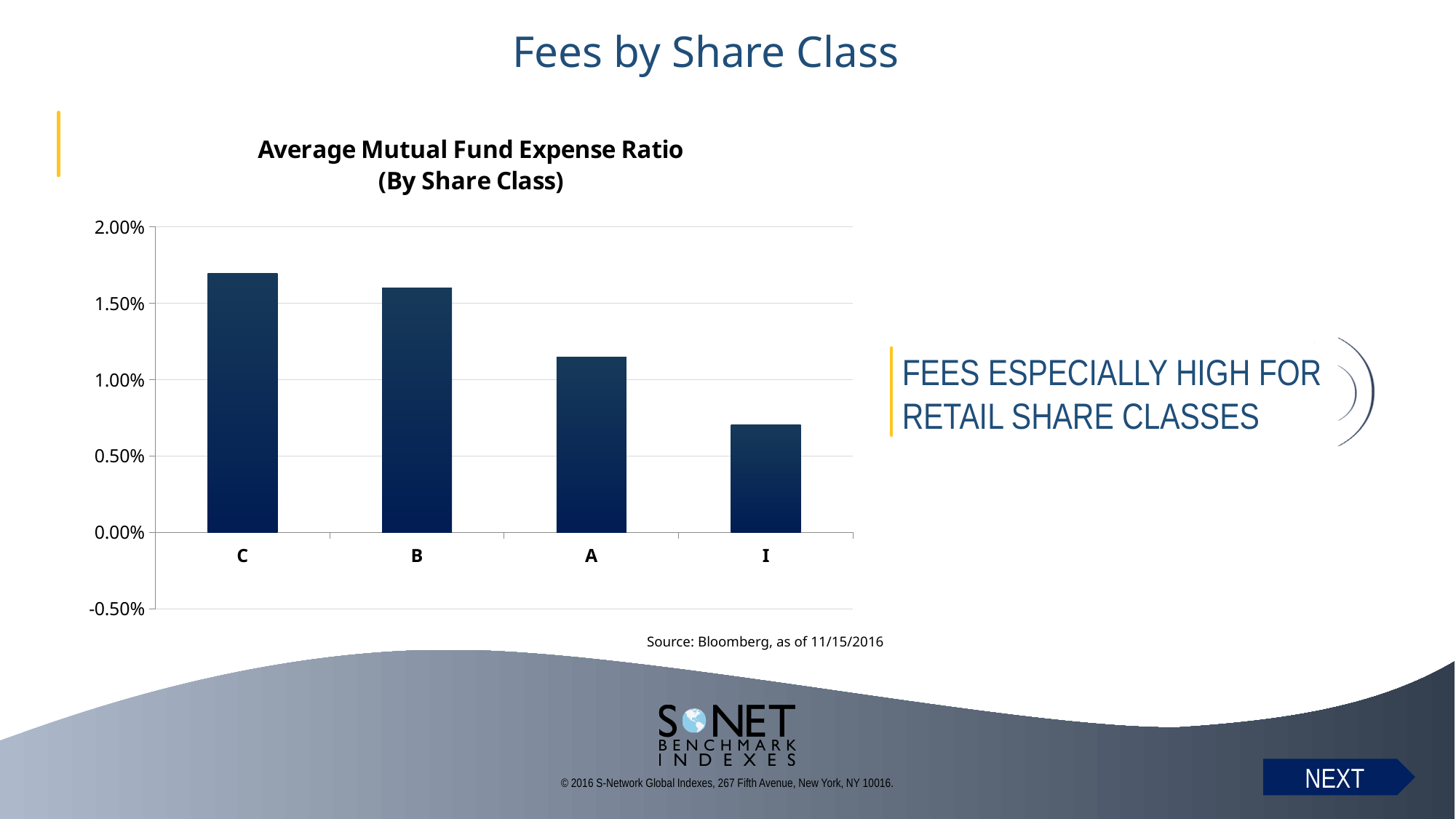
Is the average expense ratio for share class I greater or less than 1.00%? less Is the average expense ratio for share class A greater or less than 1.00%? greater What kind of chart is shown on the slide? bar chart Is the average expense ratio for share class I greater or less than 0.50%? greater What is the title of the chart? Average Mutual Fund Expense Ratio (By Share Class) Which share class has the lowest average expense ratio? I Which share class has the highest average expense ratio? C Do the expense ratios rise or fall moving from share class C to share class I along the x axis? fall How many share classes are plotted on the chart? 4 Which share class has a higher average expense ratio, B or A? B